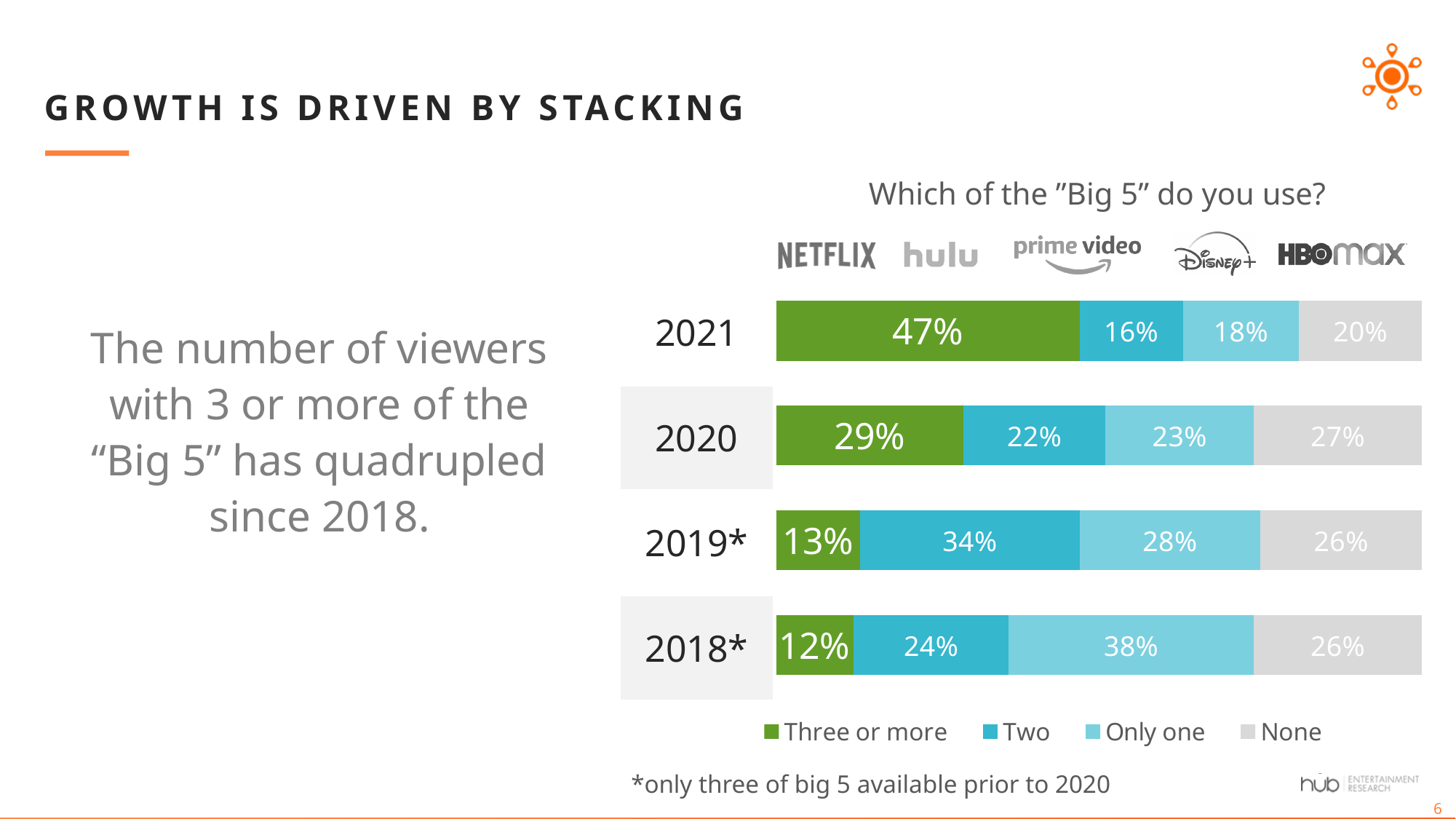
What percentage of viewers used three or more of the "Big 5" in 2021? 47% Which year has the lowest share of viewers using three or more of the "Big 5"? 2018* How many years are shown in the chart? 4 Which is larger: the "Two" share in 2019* or the "Two" share in 2018*? 2019* What percentage of viewers used two of the "Big 5" in 2019*? 34% What percentage of viewers used only one of the "Big 5" in 2018*? 38% What is the total of the 2021 bar? 101% How many series does the legend list? 4 Which year has the highest share of viewers using three or more of the "Big 5"? 2021 What is the difference in percentage points between the "Three or more" share in 2021 and in 2020? 18 What percentage of viewers used none of the "Big 5" in 2020? 27% What kind of chart is shown on the slide? Stacked bar chart